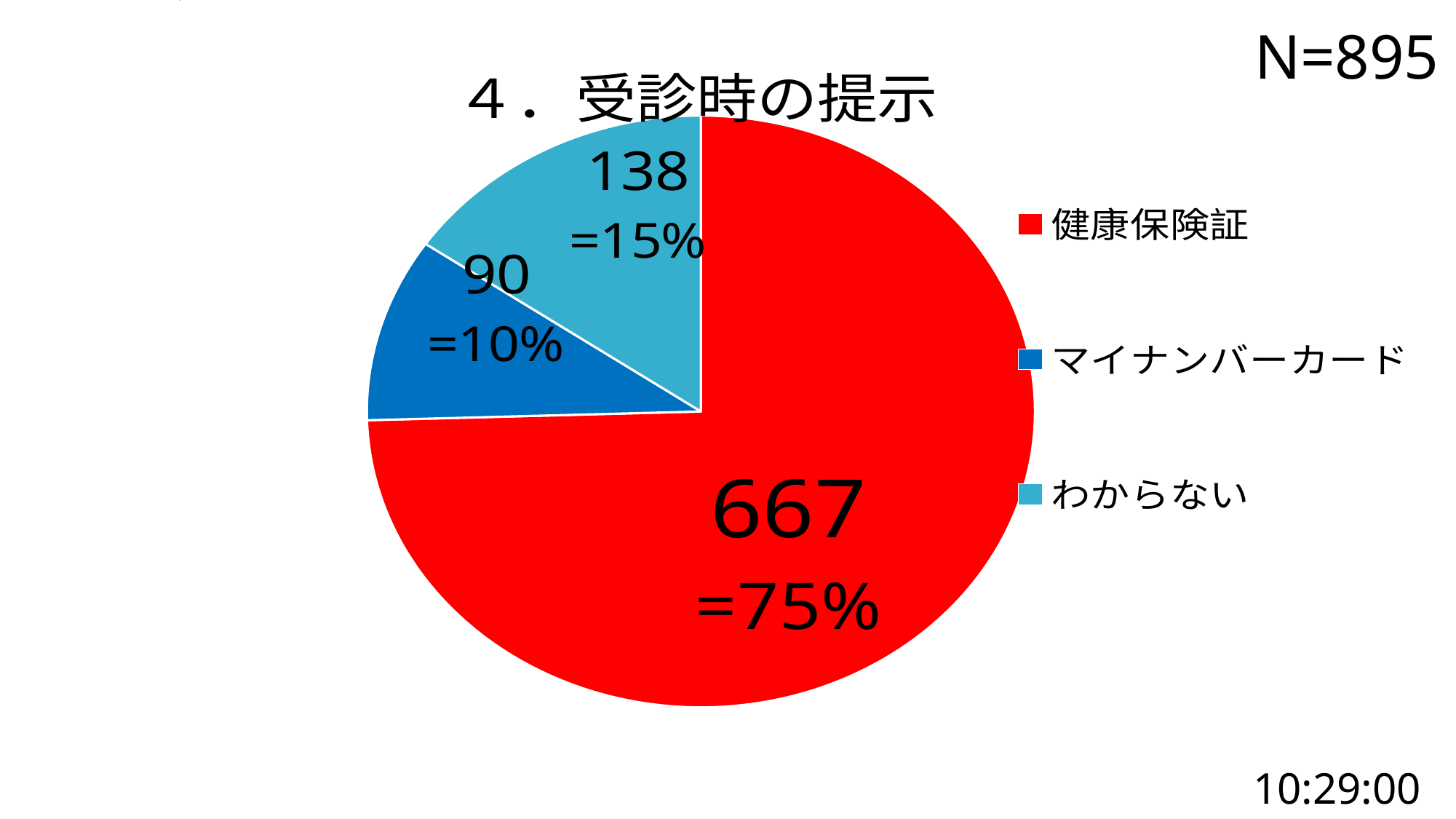
What kind of chart is shown on the slide? pie chart What is the difference between the values for わからない and マイナンバーカード? 48 What is the value for わからない? 138 Which category has the smallest slice? マイナンバーカード What is the value for 健康保険証? 667 What is the value for マイナンバーカード? 90 What share of the pie does マイナンバーカード represent? 10% What is the difference between the values for 健康保険証 and わからない? 529 Which is larger, わからない or マイナンバーカード? わからない Which category has the largest slice? 健康保険証 How many categories does the pie chart have? 3 What share of the pie does 健康保険証 represent? 75%